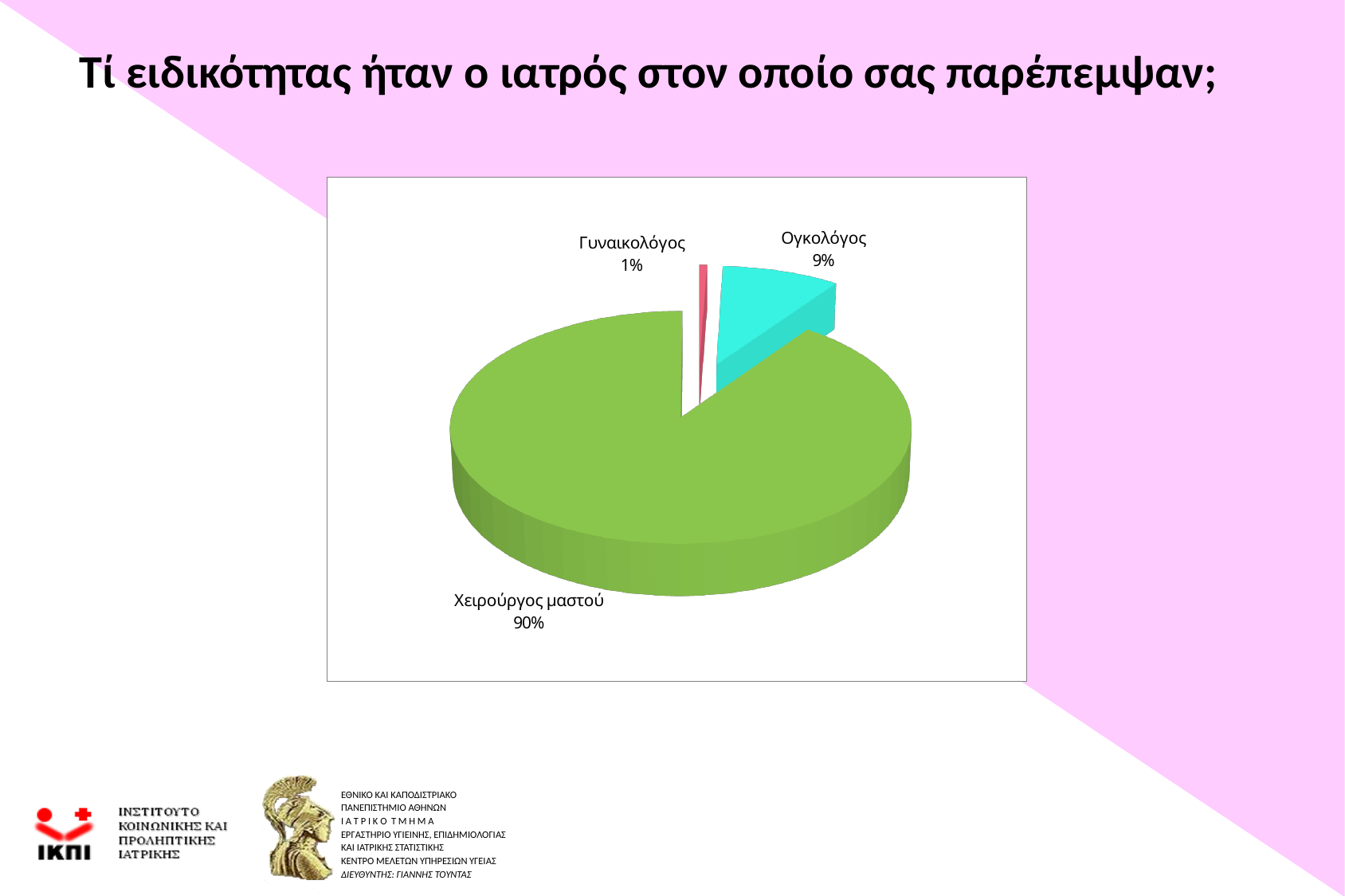
What kind of chart is shown on the slide? Pie chart What is the difference in percentage points between Ογκολόγος and Γυναικολόγος? 8 What is the title of the slide above the chart? Τί ειδικότητας ήταν ο ιατρός στον οποίο σας παρέπεμψαν; How many categories are shown in the pie chart? 3 What share of the pie does Γυναικολόγος represent? 1% Which category has the largest slice of the pie? Χειρούργος μαστού What is the difference in percentage points between Χειρούργος μαστού and Ογκολόγος? 81 What share of the pie does Χειρούργος μαστού represent? 90% Which is larger, the share for Ογκολόγος or the share for Γυναικολόγος? Ογκολόγος What share of the pie does Ογκολόγος represent? 9% Which category has the smallest slice of the pie? Γυναικολόγος What colour is the slice for Ογκολόγος? Cyan